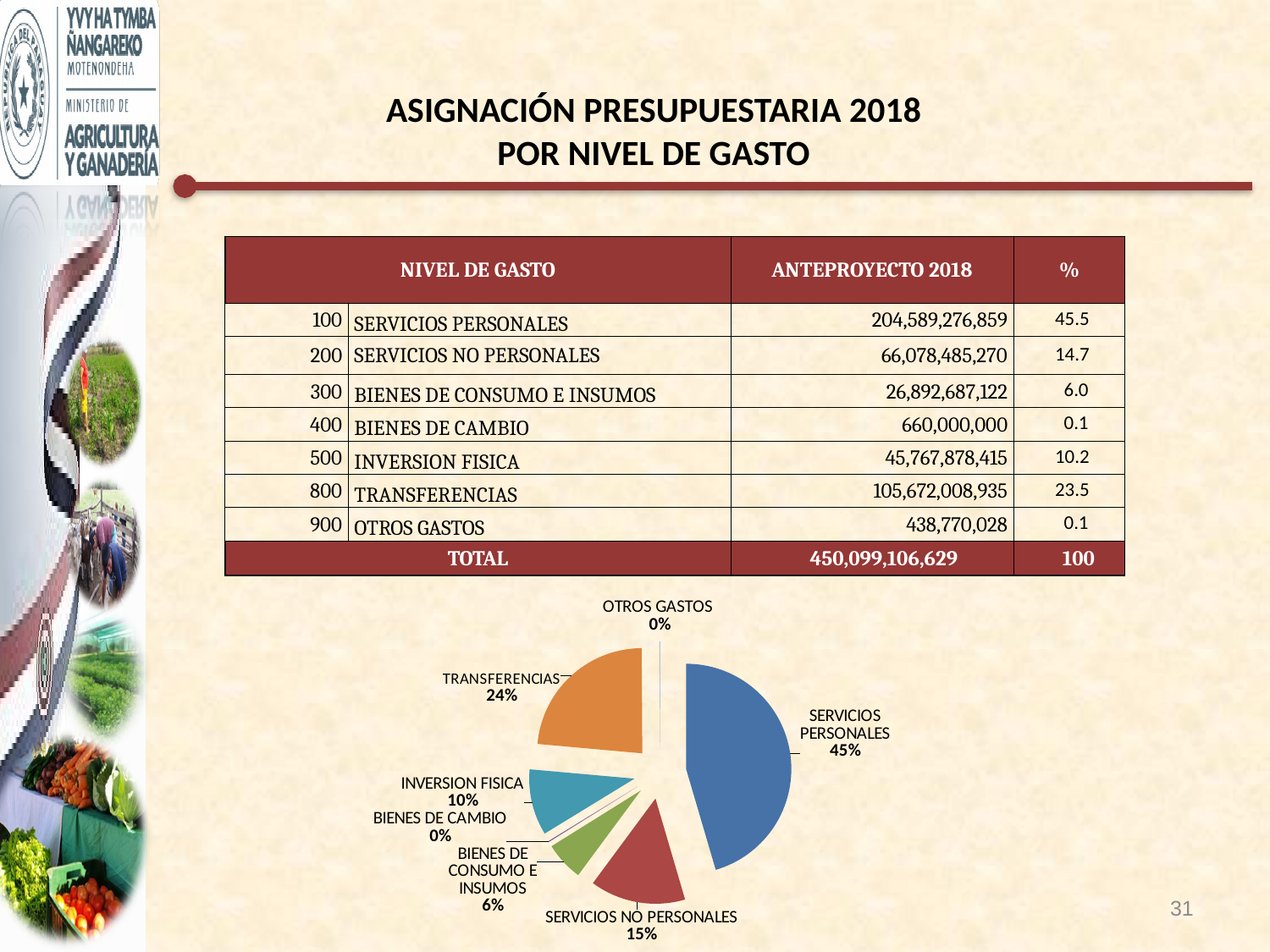
What share of the pie does INVERSION FISICA represent? 10% What is the difference in percentage points between SERVICIOS PERSONALES and TRANSFERENCIAS in the pie chart? 21 What share of the pie does BIENES DE CONSUMO E INSUMOS represent? 6% What share of the pie does SERVICIOS NO PERSONALES represent? 15% What share of the pie does SERVICIOS PERSONALES represent? 45% What share of the pie does TRANSFERENCIAS represent? 24% What percentage is shown for OTROS GASTOS in the pie chart? 0% How many slices does the pie chart have? 7 What colour is the SERVICIOS PERSONALES slice in the pie chart? blue Which is larger in the pie chart, TRANSFERENCIAS or SERVICIOS NO PERSONALES? TRANSFERENCIAS What kind of chart is shown on the slide? pie chart Which category has the largest slice of the pie chart? SERVICIOS PERSONALES